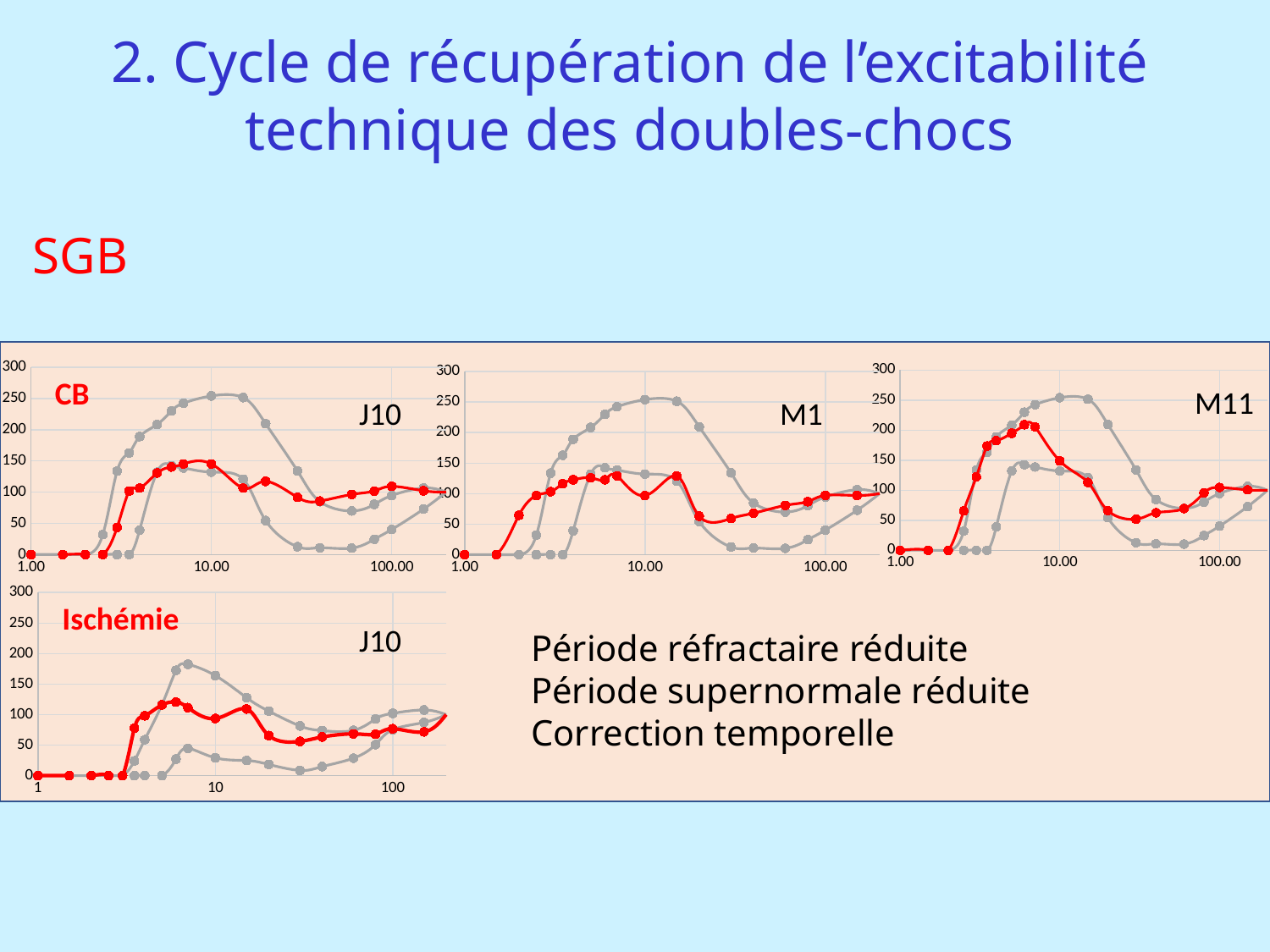
In the top-right chart (M11), is the peak value of the red line greater or less than 150? greater In the top-left chart (CB, J10), is the peak value of the red line greater or less than 100? greater In the bottom-left chart (Ischémie, J10), is the peak value of the red line greater or less than 100? greater What kind of chart is the top-left chart labelled CB J10? line chart In the top-left chart (CB, J10), does the red line rise or fall between x = 1.00 and x = 10.00? rise What is the highest value shown on the y axis of the top-left chart (CB, J10)? 300 How many charts are shown on the slide? 4 What label is printed in red in the bottom-left chart? Ischémie